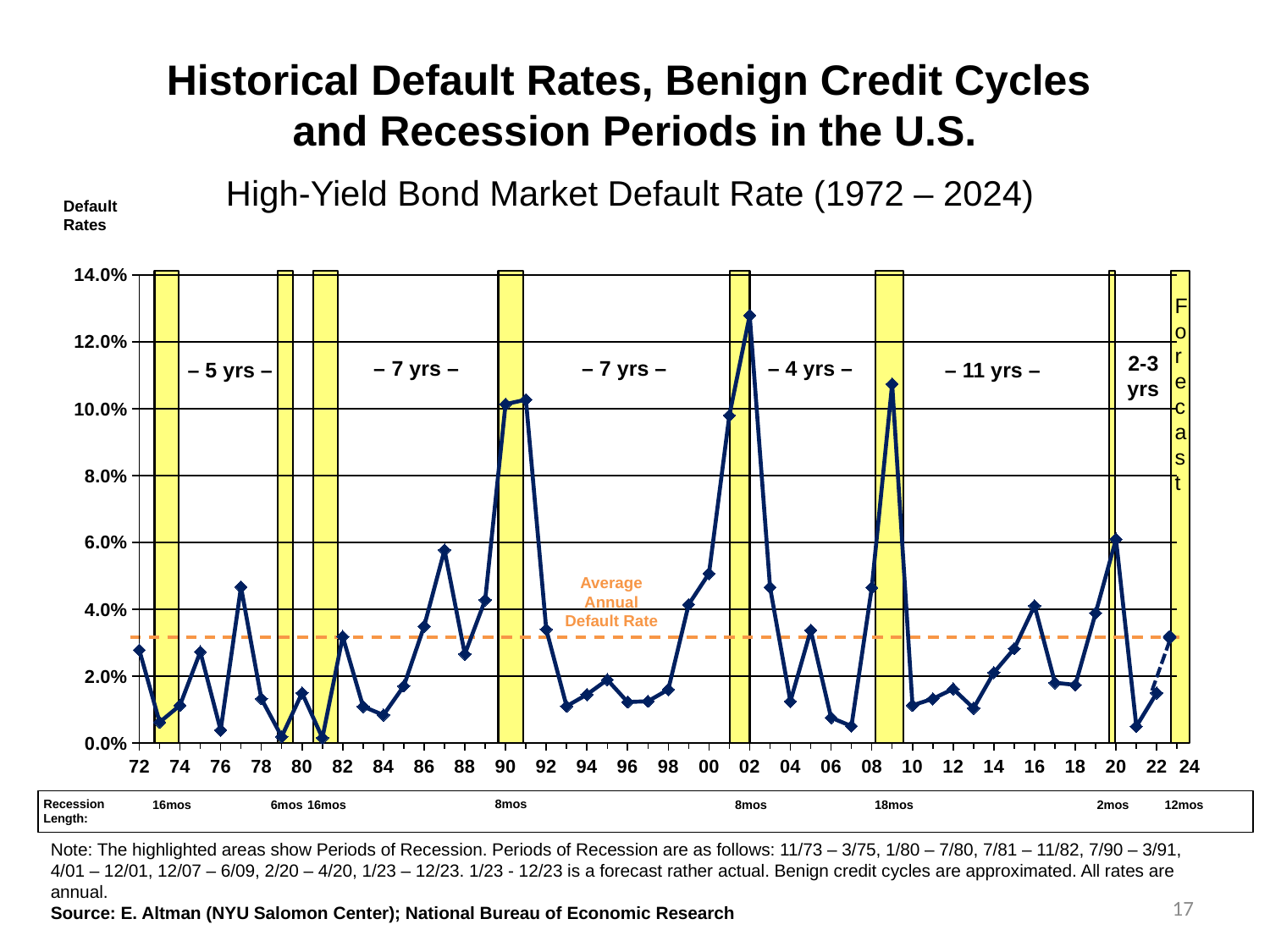
What is the recession length shown for the 2007–2009 recession? 18mos Is the default rate for 2002 greater or less than 12.0%? greater Is the default rate for 2009 greater or less than 10.0%? greater Do the default rates rise or fall from 2002 to 2007? fall Which year has the higher default rate, 2016 or 2017? 2016 How many highlighted recession periods are shown on the chart? 8 What kind of chart is shown on the slide? Line chart Which year has the higher default rate, 1990 or 2002? 2002 In which year does the high-yield bond default rate reach its highest point? 2002 What does the orange dashed horizontal line represent? Average Annual Default Rate Is the default rate for 2021 greater or less than 2.0%? less